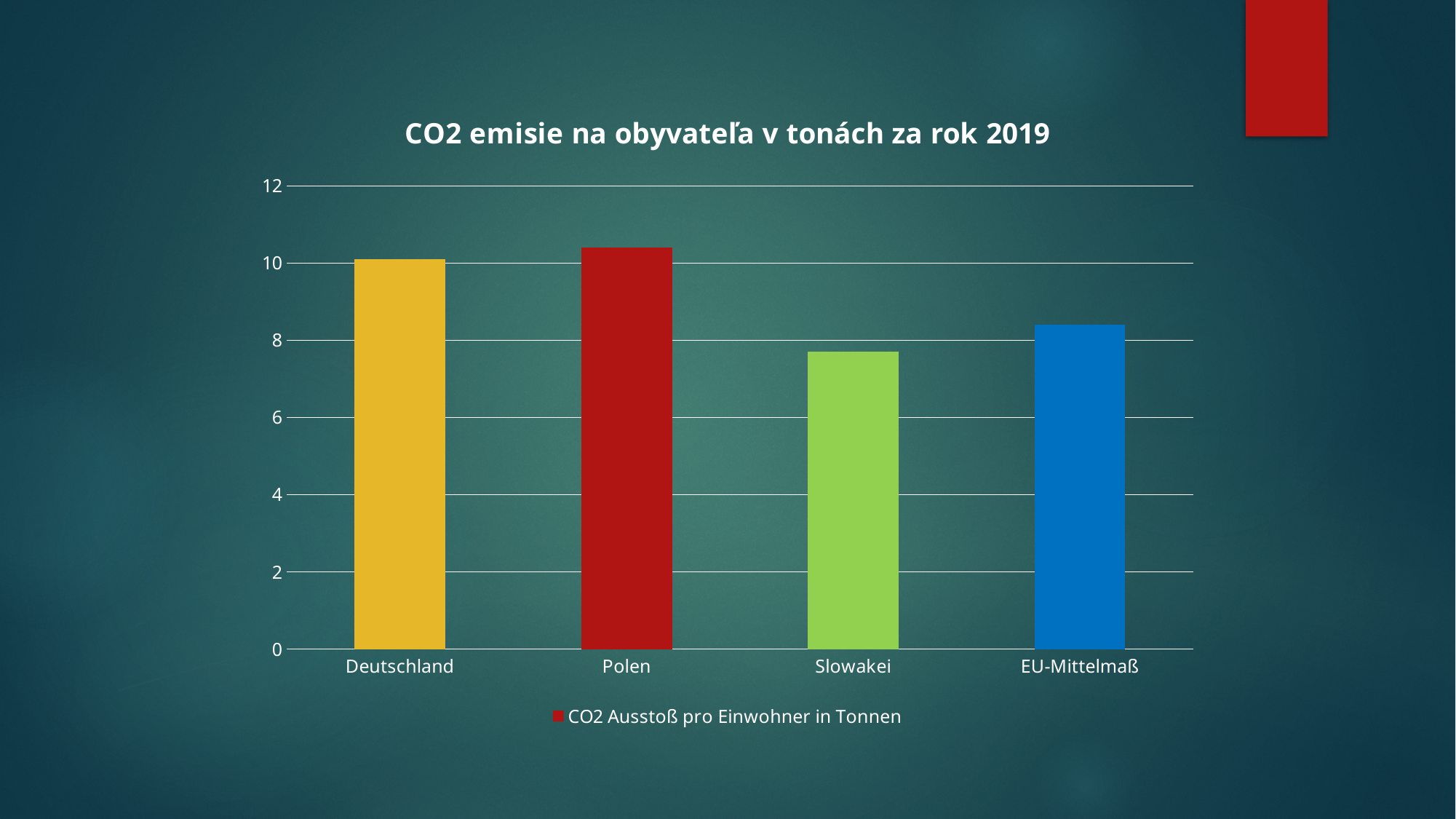
Is the value for EU-Mittelmaß greater or less than 8? greater Is the value for Slowakei greater or less than 8? less What is the legend entry for the series in the chart? CO2 Ausstoß pro Einwohner in Tonnen Is the value for Polen greater or less than 10? greater How many series does the legend list? 1 What kind of chart is shown on the slide? bar chart Which is larger, the value for Slowakei or the value for EU-Mittelmaß? EU-Mittelmaß Which is larger, the value for Deutschland or the value for Slowakei? Deutschland What is the title of the chart? CO2 emisie na obyvateľa v tonách za rok 2019 Which category has the lowest value in the chart? Slowakei Which category has the highest value in the chart? Polen How many categories are shown on the x axis of the chart? 4